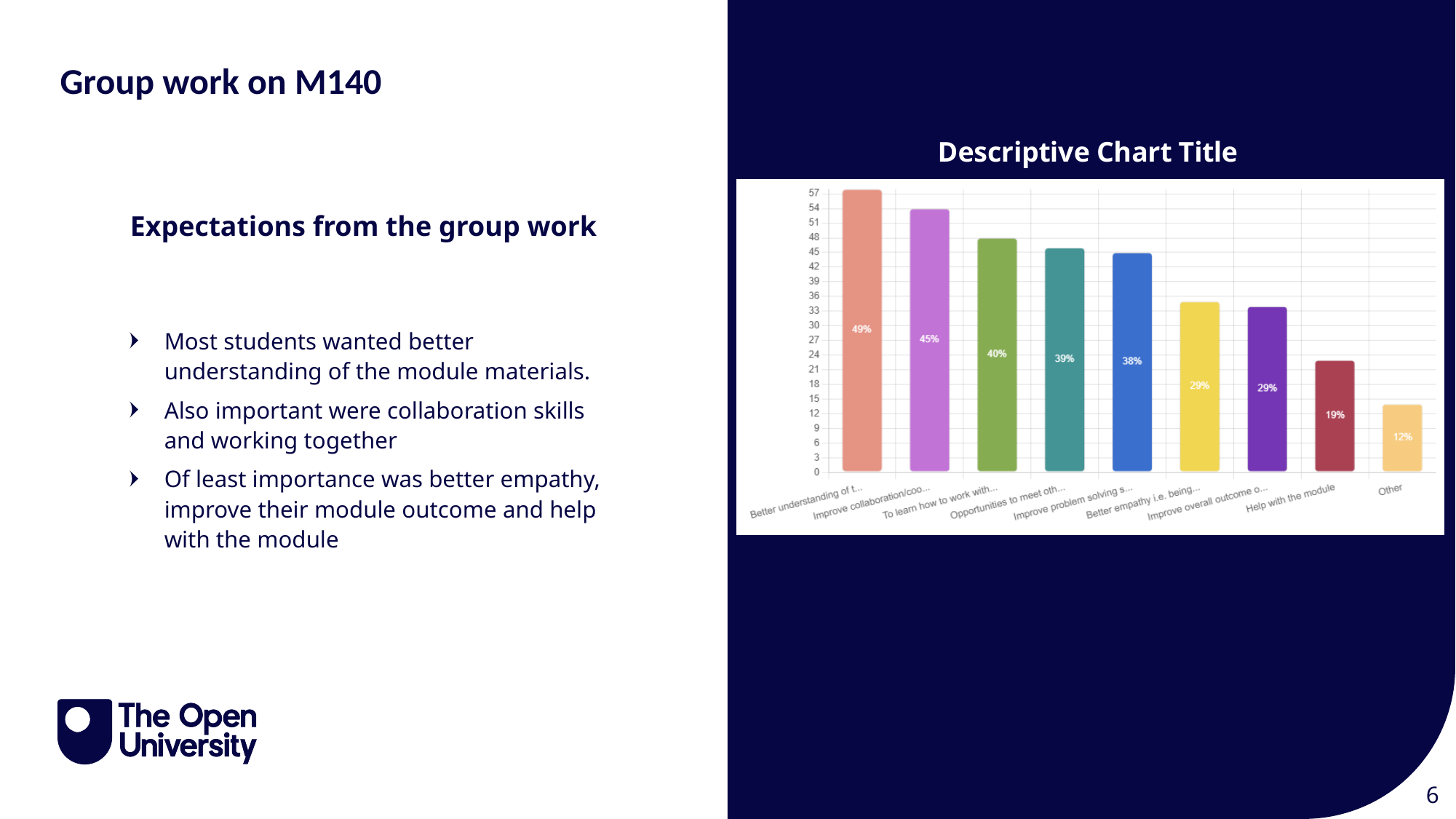
What kind of chart is shown on the slide? bar chart Which category has the tallest bar? Better understanding of t... Do the bar heights rise or fall from left to right across the chart? fall What percentage label is shown on the bar for "Improve collaboration/coo..."? 45% What percentage label is shown on the bar for "Help with the module"? 19% What percentage label is shown on the bar for "Other"? 12% Which has a higher percentage label, "To learn how to work with..." or "Help with the module"? To learn how to work with... What is the difference in percentage points between the labels for "Better understanding of t..." and "Other"? 37 How many bars are plotted in the chart? 9 What percentage label is shown on the bar for "Better understanding of t..."? 49% What is the title of the chart? Descriptive Chart Title Which category has the shortest bar? Other